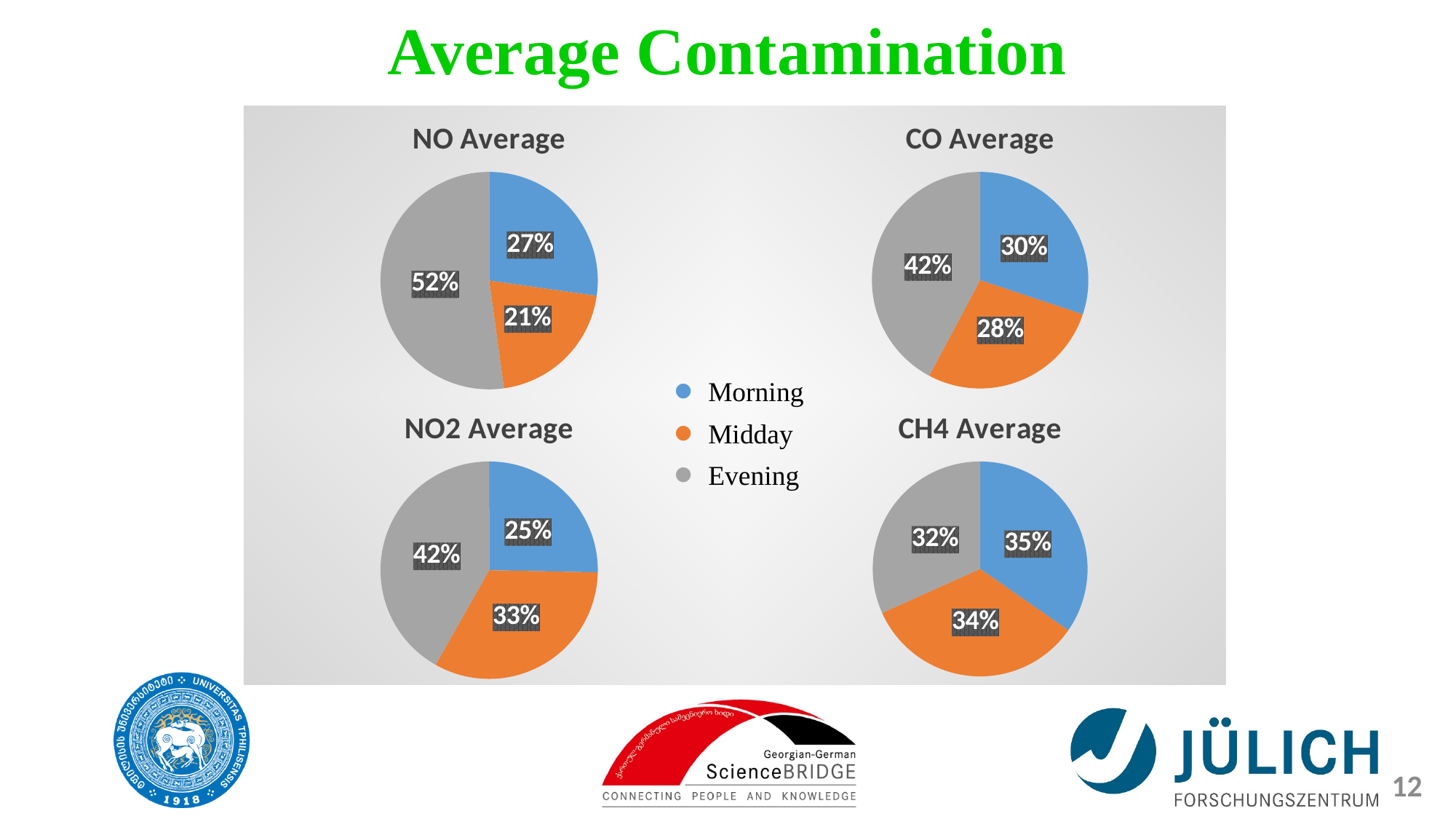
In the NO Average pie chart, what share does Evening have? 52% In the NO2 Average pie chart, what is the difference between the Evening share and the Morning share? 17% How many pie charts are shown on the slide? 4 In the CH4 Average pie chart, which time of day has the smallest share? Evening In the CO Average pie chart, what share does Midday have? 28% In the NO Average pie chart, which time of day has the smallest share? Midday How many entries does the legend list? 3 In the NO2 Average pie chart, what share does Morning have? 25% In the CH4 Average pie chart, what share does Evening have? 32% In the CO Average pie chart, which is larger, the Morning share or the Evening share? Evening What type of chart is the CO Average chart? Pie chart In the NO Average pie chart, which time of day has the largest share? Evening